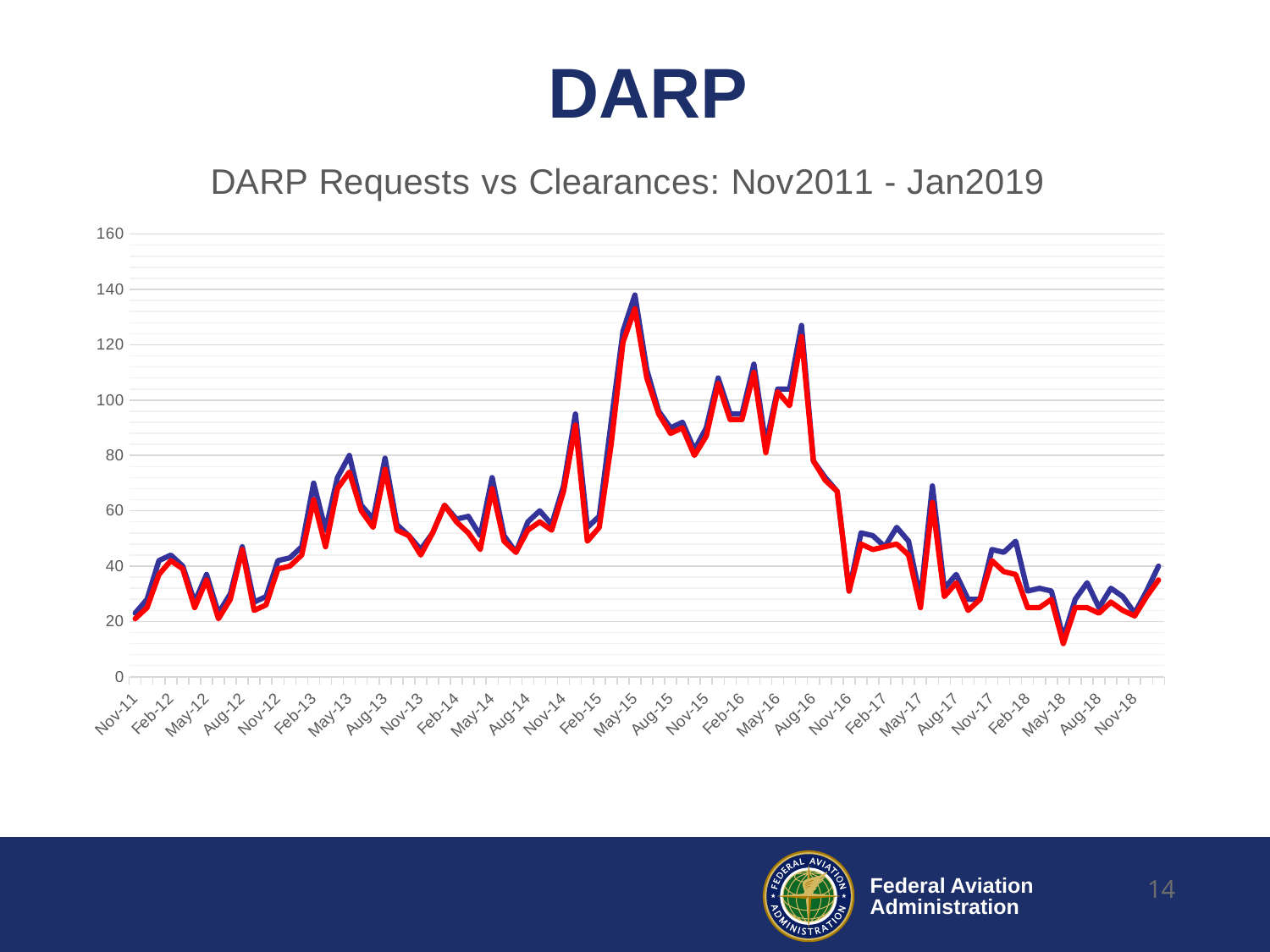
Is the value around May-18 greater or less than 20? less Is the value at Nov-11 greater or less than 40? less Around which month do the lines reach their lowest value? May-18 Which is larger, the value at May-15 or the value at Aug-16? May-15 Around which month do the lines reach their highest value? May-15 What type of chart is shown on the slide? line chart Do the values generally rise or fall between Aug-16 and Nov-16? fall How many data series (lines) are plotted on the chart? 2 What is the highest value shown on the y axis? 160 What is the title of the chart? DARP Requests vs Clearances: Nov2011 - Jan2019 Is the peak value around May-15 greater or less than 120? greater